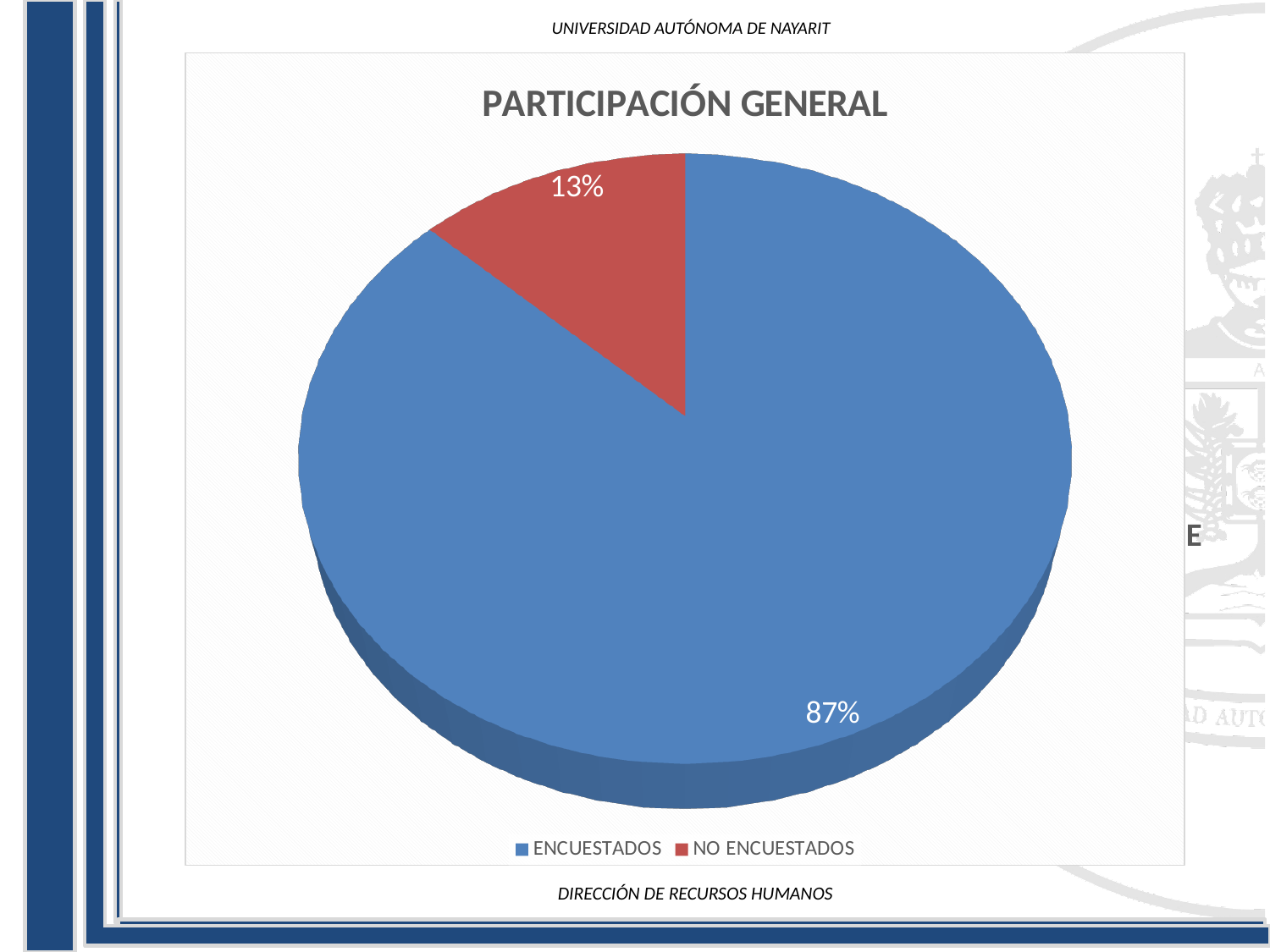
What share of the pie is ENCUESTADOS? 87% What share of the pie is NO ENCUESTADOS? 13% Which is larger, the share for ENCUESTADOS or for NO ENCUESTADOS? ENCUESTADOS How many categories does the legend list? 2 What is the title of the chart? PARTICIPACIÓN GENERAL What is the difference in percentage points between ENCUESTADOS and NO ENCUESTADOS? 74 What kind of chart is shown on the slide? Pie chart Which category has the largest slice of the pie? ENCUESTADOS Which category has the smallest slice of the pie? NO ENCUESTADOS What colour is the NO ENCUESTADOS slice? Red